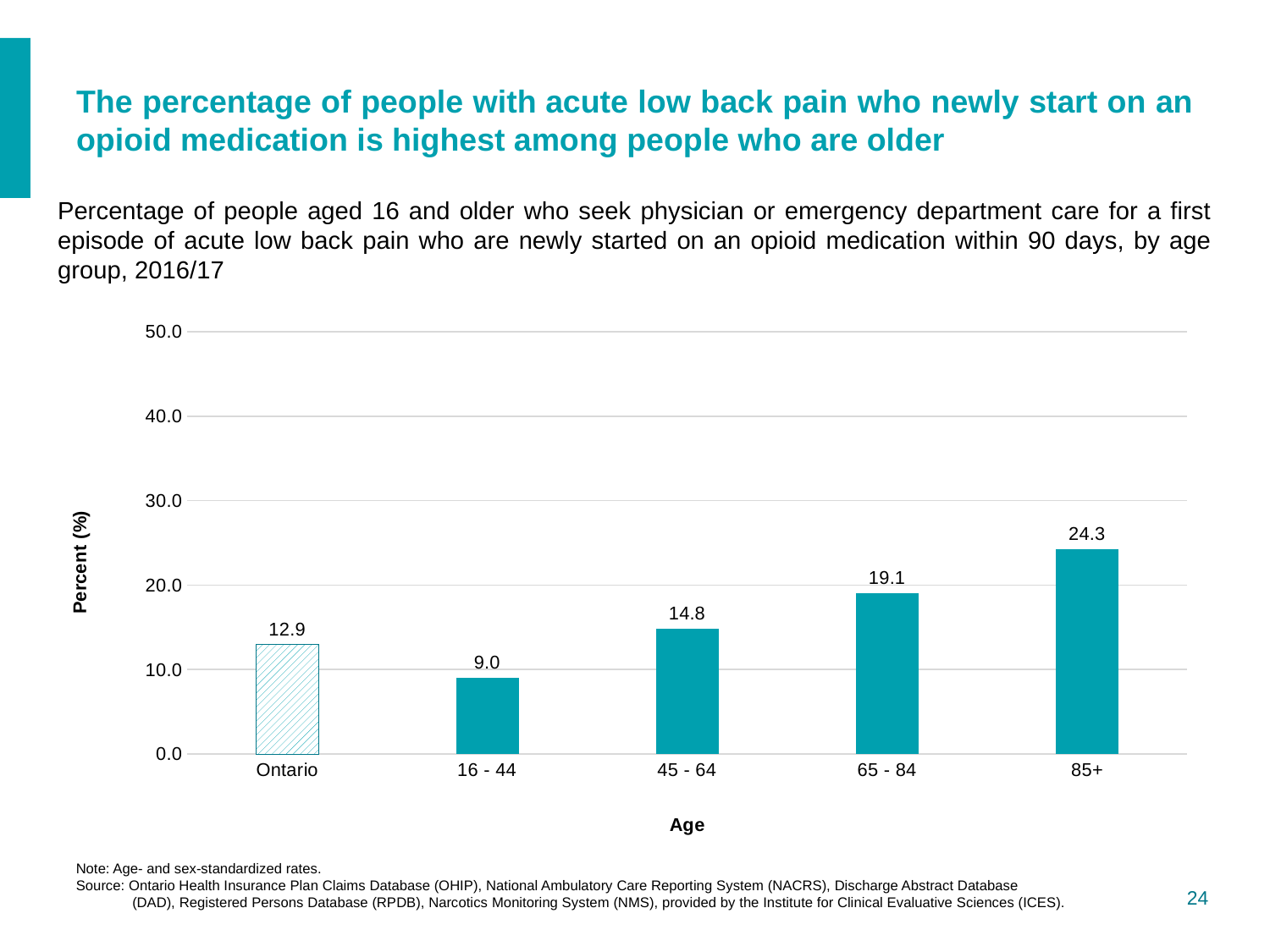
Is the value for 65 - 84 greater or less than 20.0? less Which category has the lowest value? 16 - 44 Which is larger, the value for 65 - 84 or the value for 45 - 64? 65 - 84 Which category has the highest value? 85+ What is the value for the 85+ age group? 24.3 What kind of chart is shown on the slide? bar chart What is the label of the y axis? Percent (%) What is the value for Ontario? 12.9 What is the value for the 45 - 64 age group? 14.8 Do the values rise or fall across the age groups from 16 - 44 to 85+? rise How many categories are shown on the x axis? 5 What is the difference between the values for 85+ and 16 - 44? 15.3